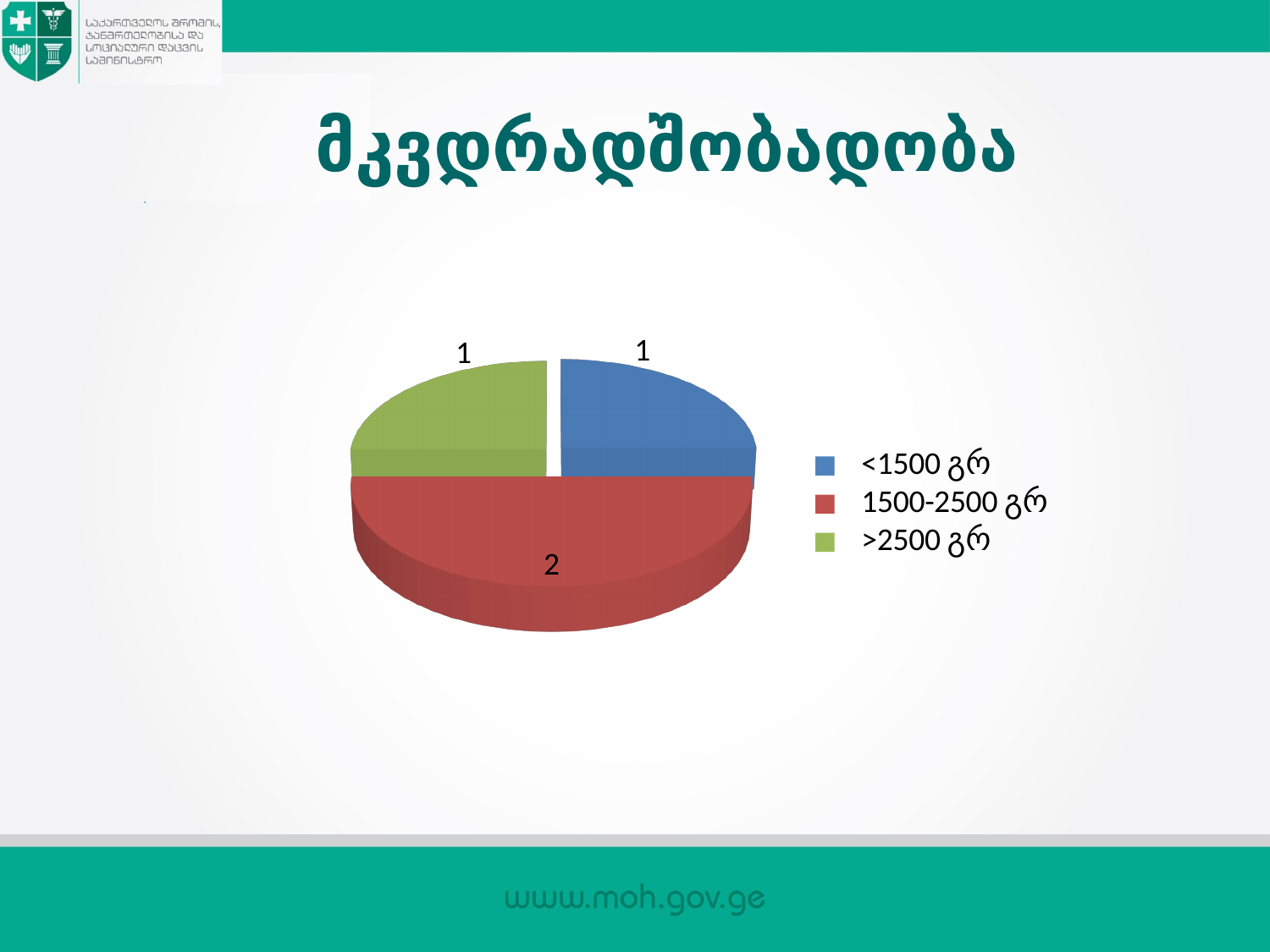
What colour is the 1500-2500 გრ slice in the pie chart? red What is the difference between the value for 1500-2500 გრ and the value for <1500 გრ? 1 What is the value for the <1500 გრ slice? 1 Which is larger, the value for 1500-2500 გრ or the value for >2500 გრ? 1500-2500 გრ What share of the pie does the 1500-2500 გრ slice represent? 50% What is the value for the 1500-2500 გრ slice? 2 What is the value for the >2500 გრ slice? 1 What type of chart is shown on the slide? pie chart What is the total of all the values shown on the pie chart? 4 What share of the pie does the <1500 გრ slice represent? 25% Which category has the largest slice of the pie? 1500-2500 გრ How many slices does the pie chart have? 3